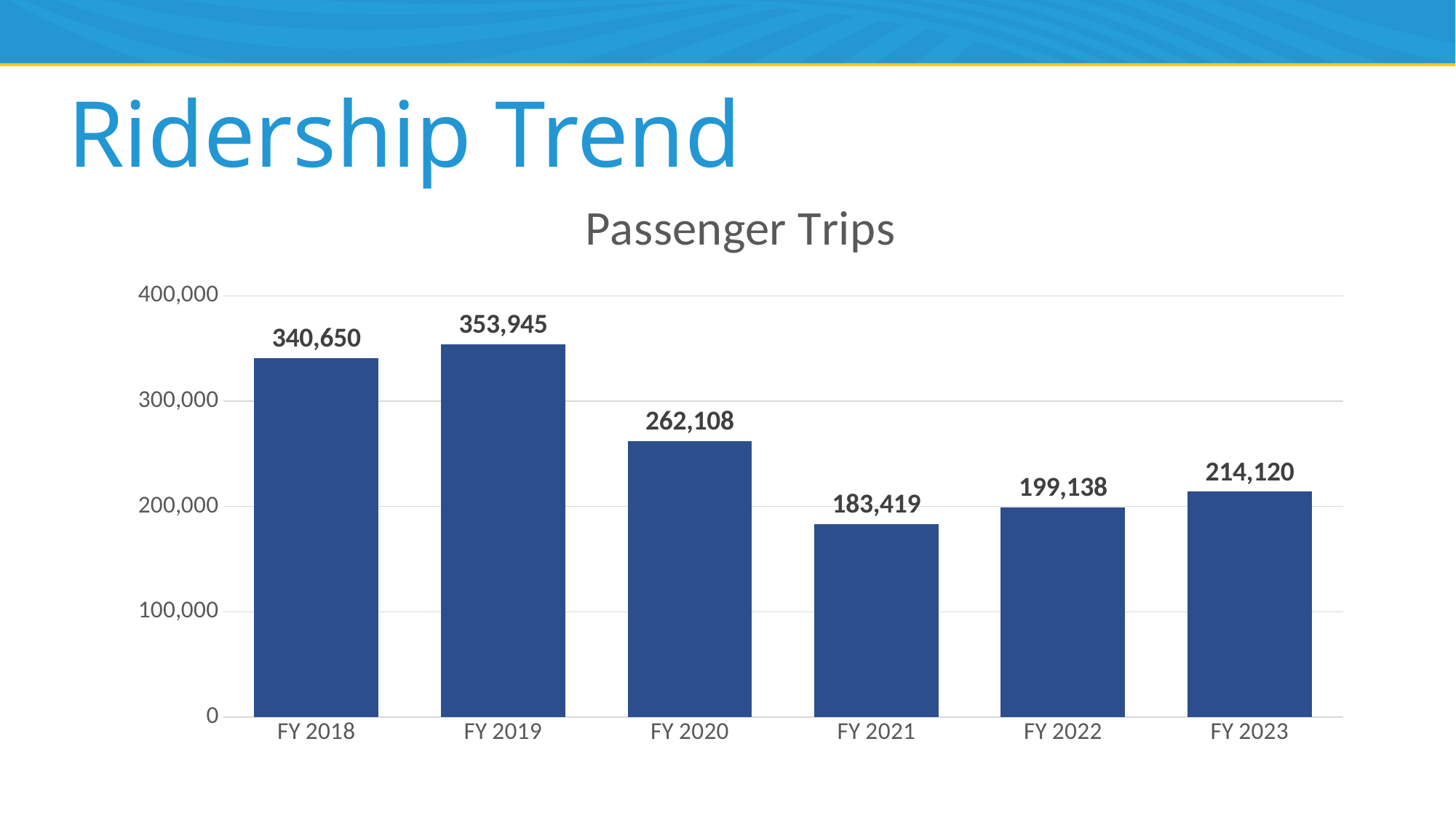
Is the value for FY 2021 greater or less than 200,000? less What is the value for FY 2020 in the Passenger Trips chart? 262,108 How many passenger trips are shown for FY 2023? 214,120 Do passenger trips rise or fall from FY 2019 to FY 2021? fall By how much did passenger trips increase from FY 2022 to FY 2023? 14,982 What kind of chart is used to show Passenger Trips? bar chart Which fiscal year has the lowest number of passenger trips? FY 2021 Which year had more passenger trips, FY 2020 or FY 2022? FY 2020 How many fiscal years are shown on the x axis of the chart? 6 What is the difference in passenger trips between FY 2019 and FY 2018? 13,295 What is the title of the chart on the slide? Passenger Trips Which fiscal year has the highest number of passenger trips? FY 2019